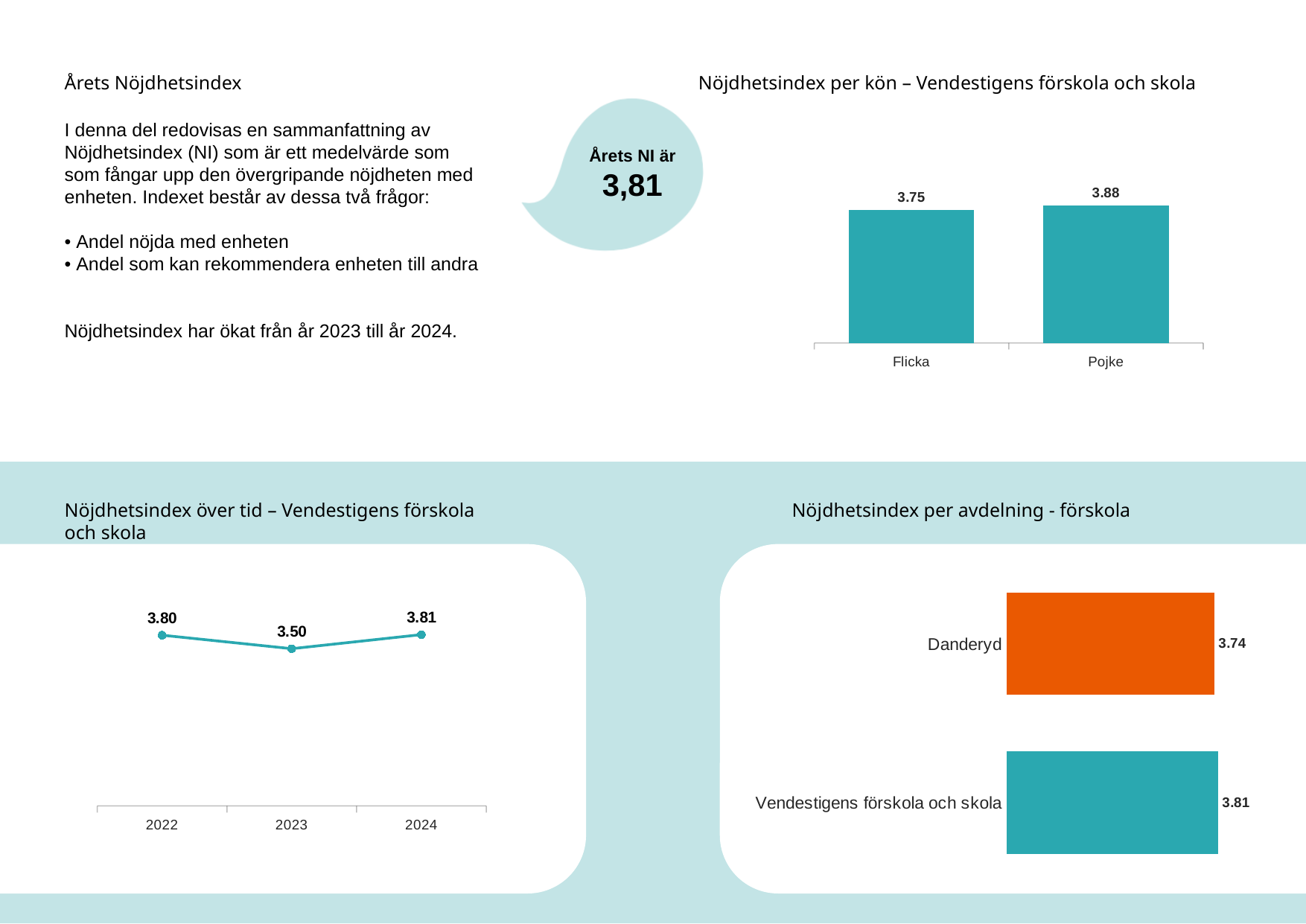
What kind of chart is 'Nöjdhetsindex över tid – Vendestigens förskola och skola'? Line chart In the chart 'Nöjdhetsindex per avdelning - förskola', which is larger: Danderyd or Vendestigens förskola och skola? Vendestigens förskola och skola In the chart 'Nöjdhetsindex per kön – Vendestigens förskola och skola', what is the value for Pojke? 3.88 In the chart 'Nöjdhetsindex över tid – Vendestigens förskola och skola', did the value rise or fall from 2023 to 2024? Rise What kind of chart is 'Nöjdhetsindex per kön – Vendestigens förskola och skola'? Bar chart In the chart 'Nöjdhetsindex över tid – Vendestigens förskola och skola', which year has the lowest value? 2023 In the chart 'Nöjdhetsindex per kön – Vendestigens förskola och skola', what is the difference between the values for Pojke and Flicka? 0.13 In the chart 'Nöjdhetsindex över tid – Vendestigens förskola och skola', what is the value for 2023? 3.50 In the chart 'Nöjdhetsindex per avdelning - förskola', what is the value for Danderyd? 3.74 In the chart 'Nöjdhetsindex per kön – Vendestigens förskola och skola', which category has the higher value? Pojke In the chart 'Nöjdhetsindex över tid – Vendestigens förskola och skola', how many data points are plotted? 3 In the chart 'Nöjdhetsindex per kön – Vendestigens förskola och skola', what is the value for Flicka? 3.75